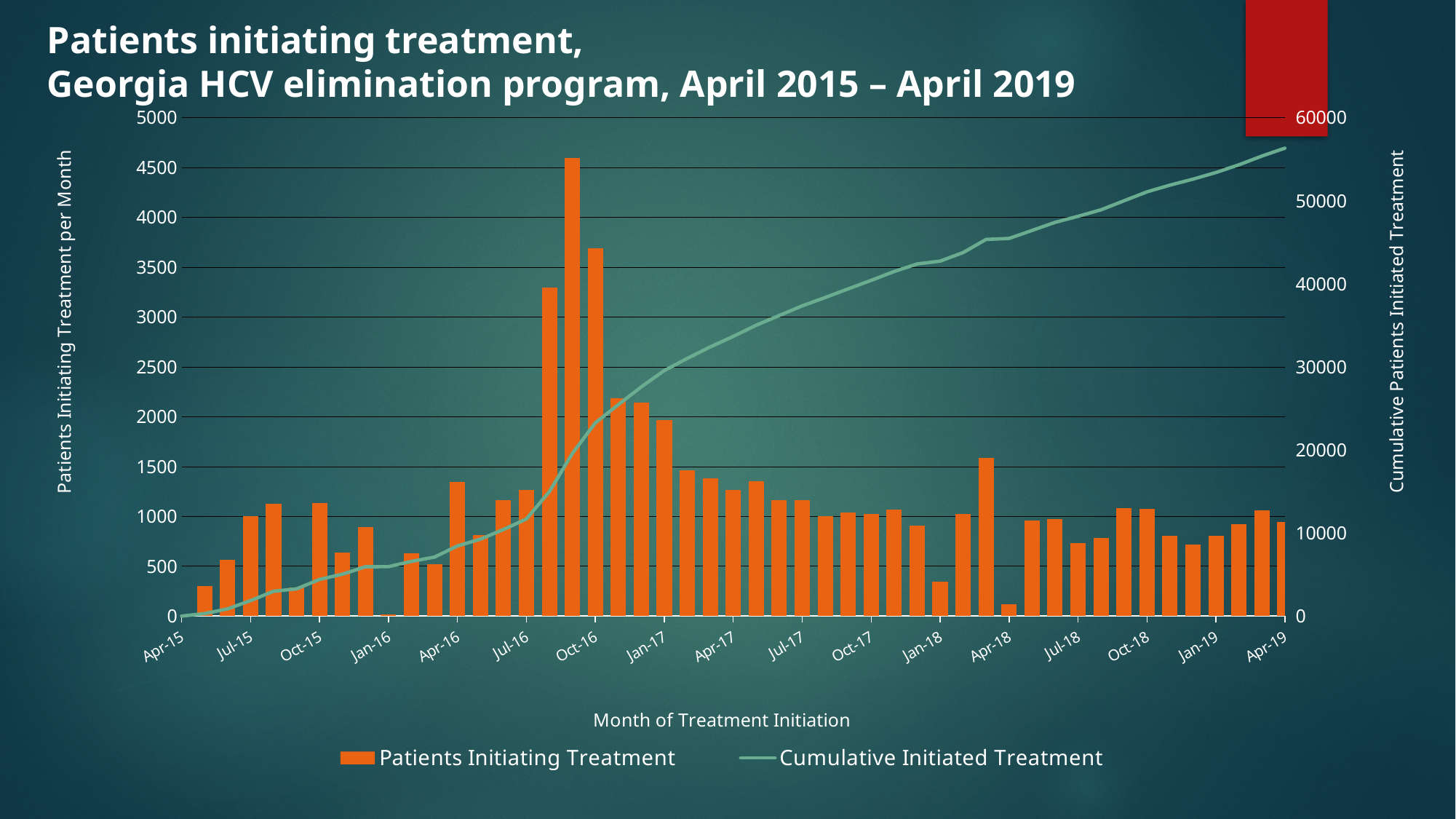
What is the title of the left vertical axis? Patients Initiating Treatment per Month Which month had more patients initiating treatment, Apr-18 or Jul-18? Jul-18 Does the Cumulative Initiated Treatment line rise or fall from Apr-15 to Apr-19? Rises Which month had more patients initiating treatment, Oct-16 or Apr-16? Oct-16 Is the value for Patients Initiating Treatment in Apr-16 greater or less than 1000? greater Is the value for Cumulative Initiated Treatment in Jan-18 greater or less than 40000? greater Is the value for Cumulative Initiated Treatment in Apr-19 greater or less than 50000? greater How many series does the legend list? 2 Which series is drawn as a line? Cumulative Initiated Treatment What kind of chart is shown on the slide? A combined bar and line chart